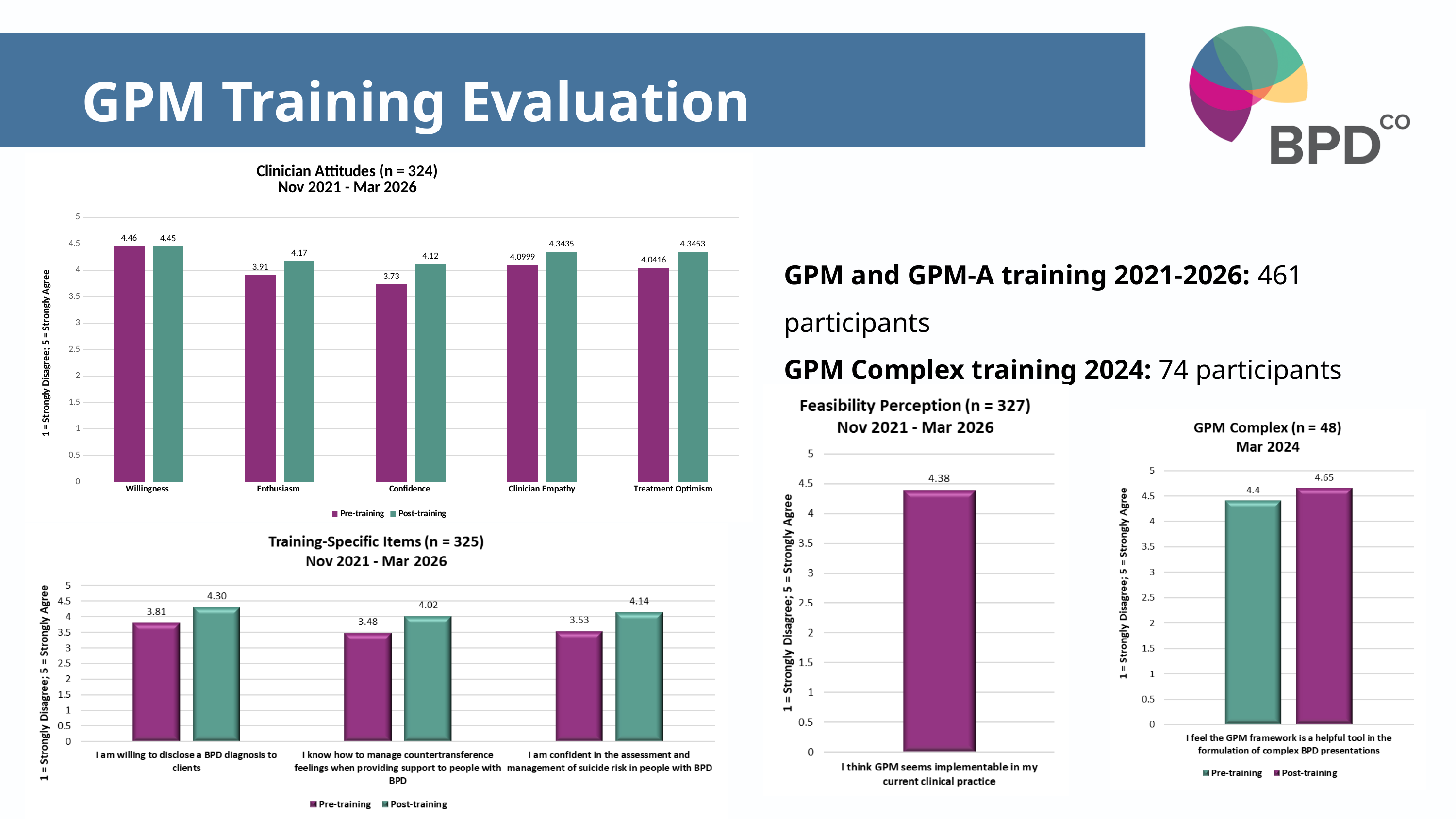
In the GPM Complex chart, what is the Post-training value? 4.65 In the Clinician Attitudes chart, what is the Post-training value for Treatment Optimism? 4.3453 In the Clinician Attitudes chart, which is larger for Enthusiasm, the Pre-training or the Post-training value? Post-training In the Training-Specific Items chart, how many items are shown on the x axis? 3 What kind of chart is the Feasibility Perception chart? Bar chart In the Training-Specific Items chart, which item has the highest Post-training value? I am willing to disclose a BPD diagnosis to clients In the Feasibility Perception chart, what is the value for 'I think GPM seems implementable in my current clinical practice'? 4.38 In the Training-Specific Items chart, what is the difference between the Post-training and Pre-training values for 'I am willing to disclose a BPD diagnosis to clients'? 0.49 In the Clinician Attitudes chart, what is the Pre-training value for Confidence? 3.73 In the Clinician Attitudes chart, how many series does the legend list? 2 In the Clinician Attitudes chart, which category has the lowest Pre-training value? Confidence In the GPM Complex chart, what is the difference between the Post-training and Pre-training values? 0.25